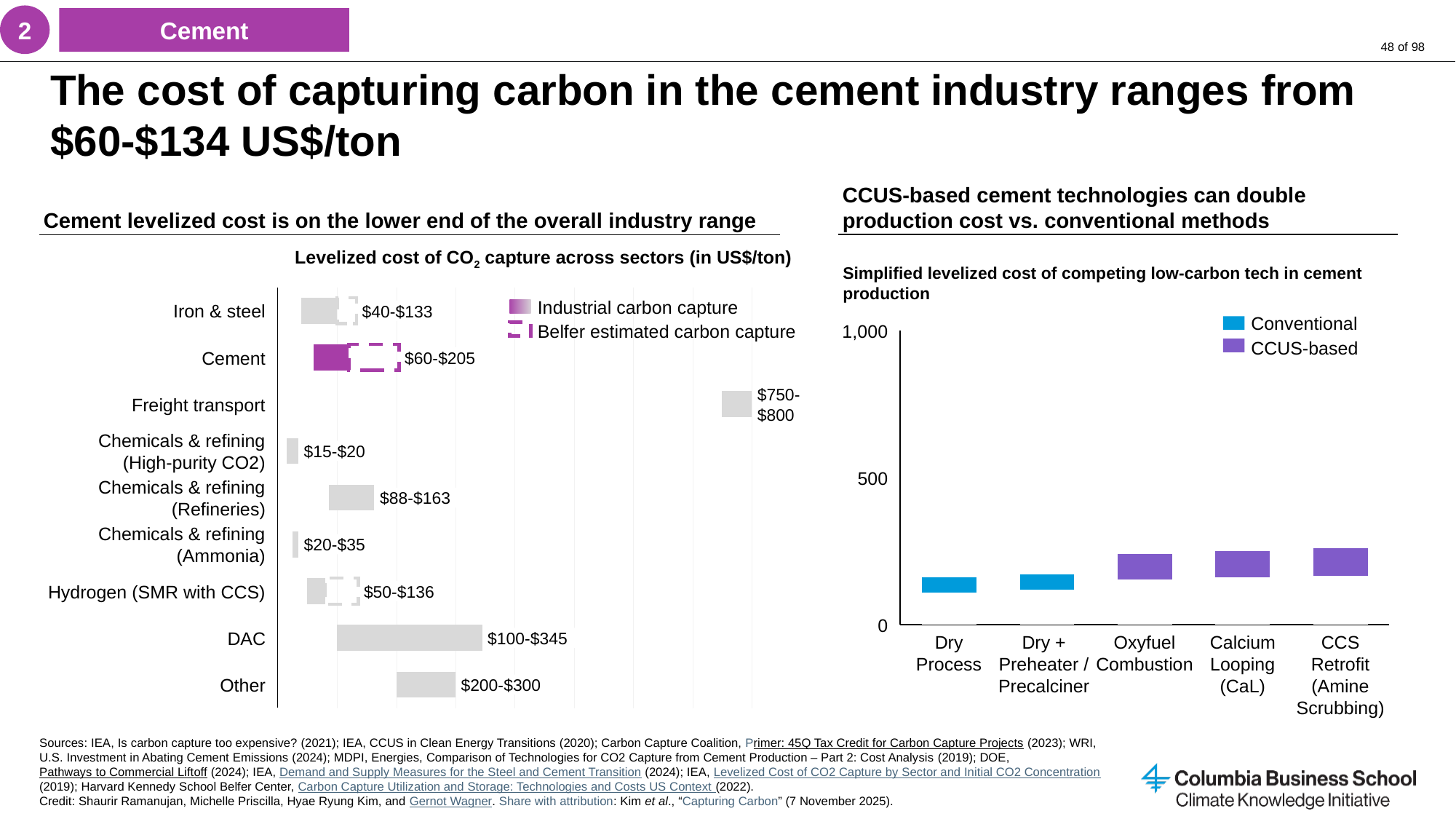
In the 'Levelized cost of CO2 capture across sectors' chart, which sector has the lowest cost range? Chemicals & refining (High-purity CO2) In the 'Levelized cost of CO2 capture across sectors' chart, what is the cost range shown for Cement? $60-$205 In the 'Levelized cost of CO2 capture across sectors' chart, what is the cost range shown for Freight transport? $750-$800 In the 'Simplified levelized cost of competing low-carbon tech in cement production' chart, which series does the legend associate with the blue colour? Conventional In the 'Levelized cost of CO2 capture across sectors' chart, what is the cost range shown for Hydrogen (SMR with CCS)? $50-$136 In the 'Levelized cost of CO2 capture across sectors' chart, what is the cost range shown for DAC? $100-$345 How many entries does the legend of the 'Levelized cost of CO2 capture across sectors' chart list? 2 In the 'Simplified levelized cost of competing low-carbon tech in cement production' chart, how many technologies are shown on the x axis? 5 In the 'Simplified levelized cost of competing low-carbon tech in cement production' chart, which is larger: the value for Oxyfuel Combustion or for Dry Process? Oxyfuel Combustion In the 'Levelized cost of CO2 capture across sectors' chart, which sector has the highest cost range? Freight transport In the 'Simplified levelized cost of competing low-carbon tech in cement production' chart, is the value for Oxyfuel Combustion greater or less than 500? less How many sectors are listed in the 'Levelized cost of CO2 capture across sectors' chart? 9